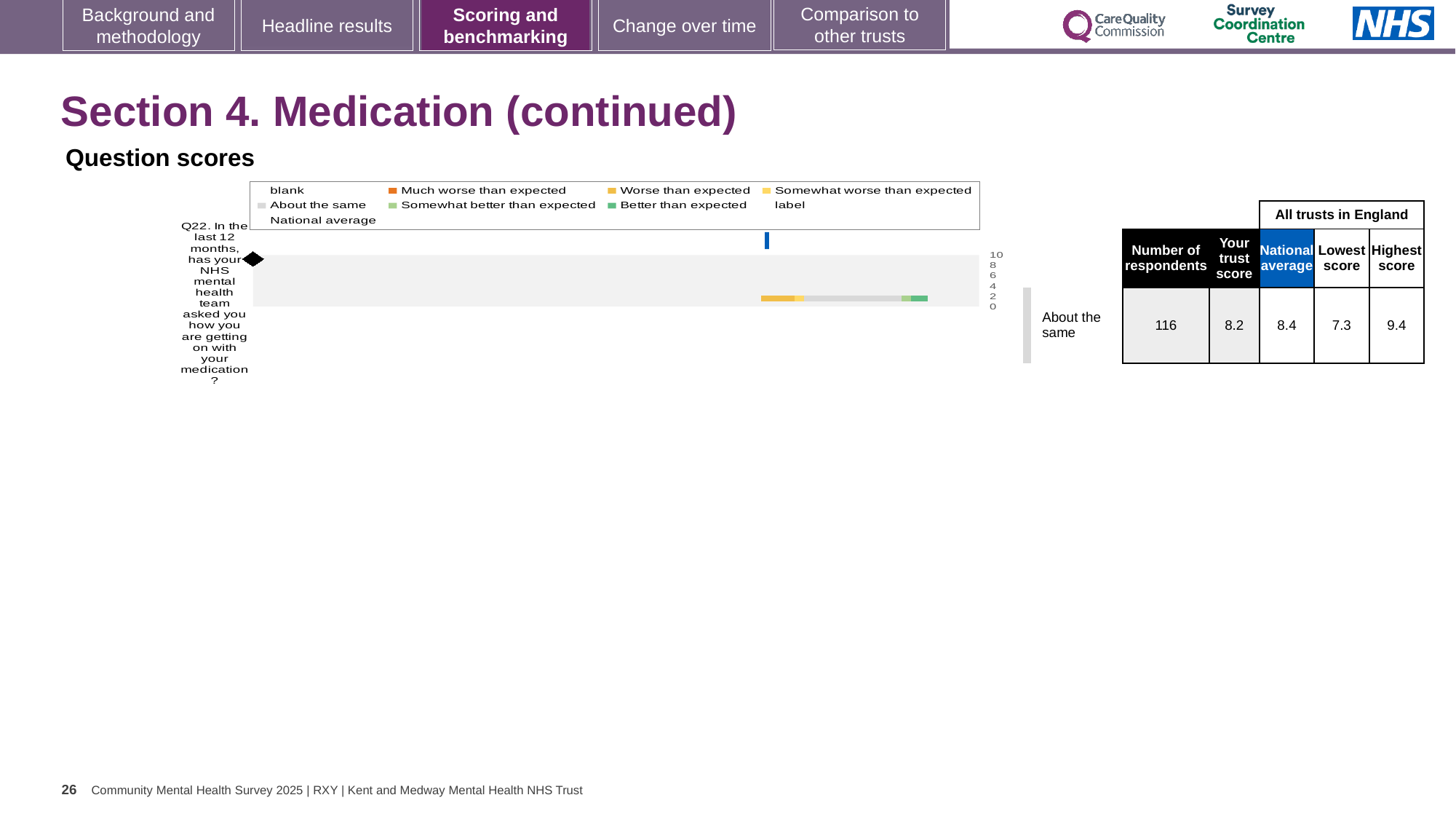
What is the national average score for Q22? 8.4 What is the difference between the highest and lowest scores for Q22? 2.1 What kind of chart is used to show the Q22 question score? bar chart Which legend entry is shown in orange? Much worse than expected How many questions are plotted on the chart? 1 What is the trust score for Q22? 8.2 What benchmark category is Q22 rated as, according to the label beside the chart? About the same What is the highest score among all trusts in England for Q22? 9.4 Is the trust score for Q22 higher or lower than the national average? lower What is the difference between the national average and the trust score for Q22? 0.2 How many respondents answered Q22? 116 What is the lowest score among all trusts in England for Q22? 7.3